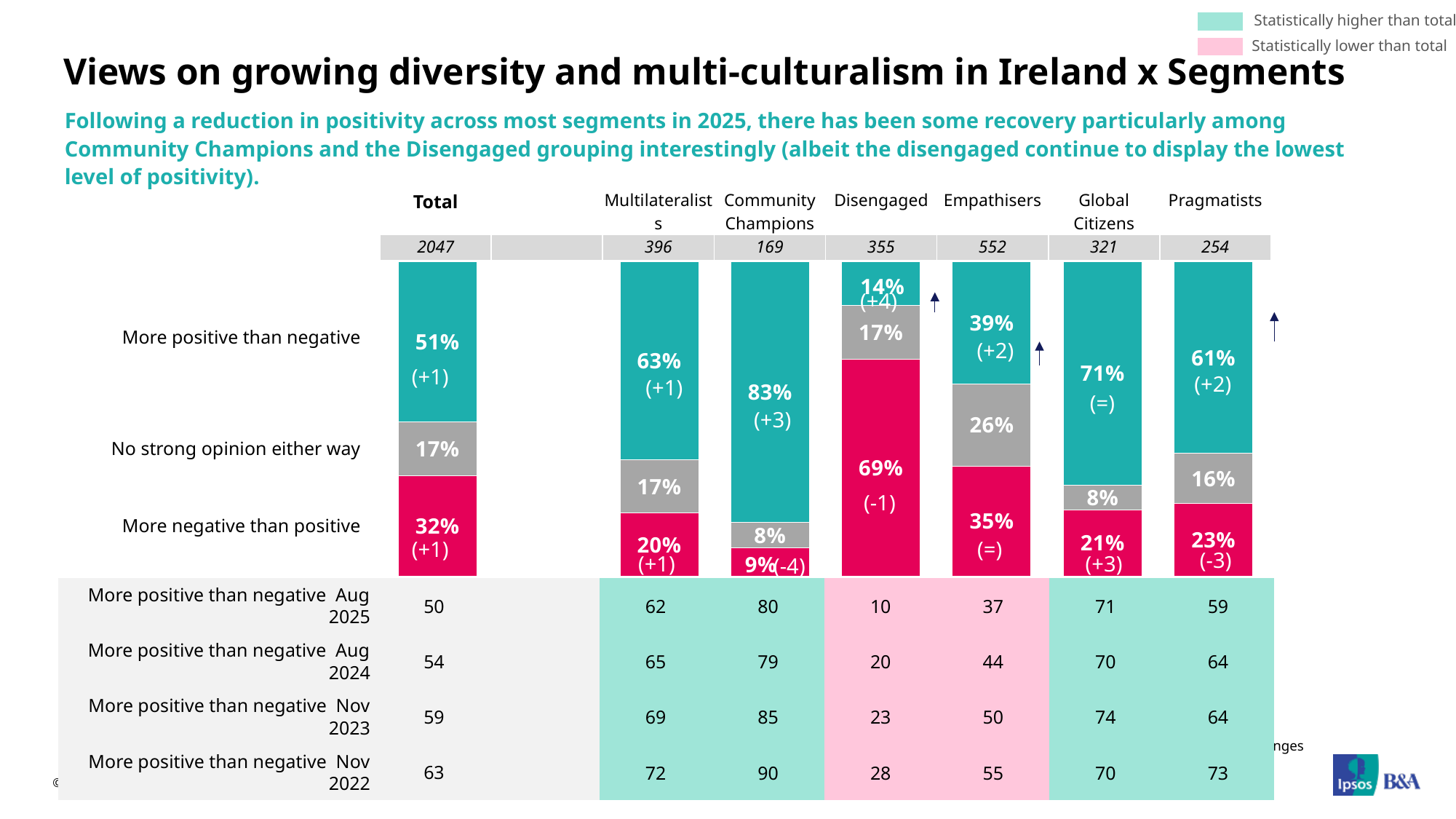
Which segment has the lowest share of 'More positive than negative'? Disengaged What percentage of the Total are 'More positive than negative'? 51% What is the sample size shown for the Empathisers segment? 552 Which segment has the highest share of 'More positive than negative'? Community Champions How many segment bars are shown in the chart, including Total? 7 What type of chart is used on this slide? Stacked bar chart What percentage of Empathisers have 'No strong opinion either way'? 26% Which is larger: the 'More negative than positive' share for Multilateralists or for Pragmatists? Pragmatists What percentage of the Disengaged segment are 'More negative than positive'? 69% What percentage of Community Champions are 'More positive than negative'? 83% How many response categories are stacked in each bar? 3 What is the difference in percentage points between the 'More positive than negative' share for Global Citizens and for Pragmatists? 10